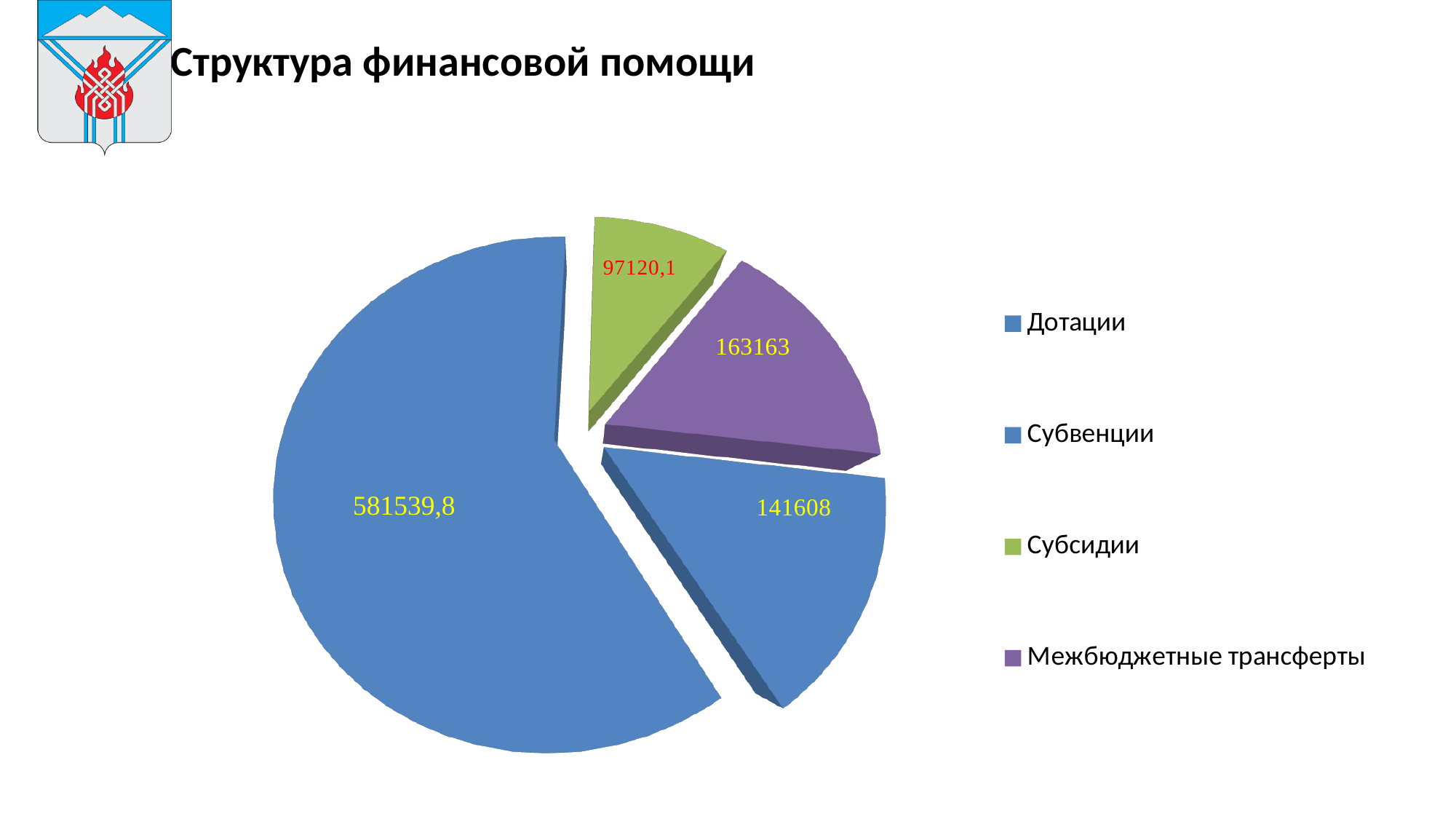
What is the value shown for Субсидии? 97120,1 Which category has the smallest slice in the pie chart? Субсидии What is the value shown for Межбюджетные трансферты? 163163 What is the value of the largest slice in the pie chart? 581539,8 What is the title of the chart? Структура финансовой помощи Which is larger, the value for Межбюджетные трансферты or the value for Субсидии? Межбюджетные трансферты What is the value of the smallest slice in the pie chart? 97120,1 What is the difference between the values for Межбюджетные трансферты and Субсидии? 66042,9 How many slices does the pie chart have? 4 What colour is the slice for Субсидии? green What kind of chart is shown on the slide? pie chart How many entries does the legend list? 4